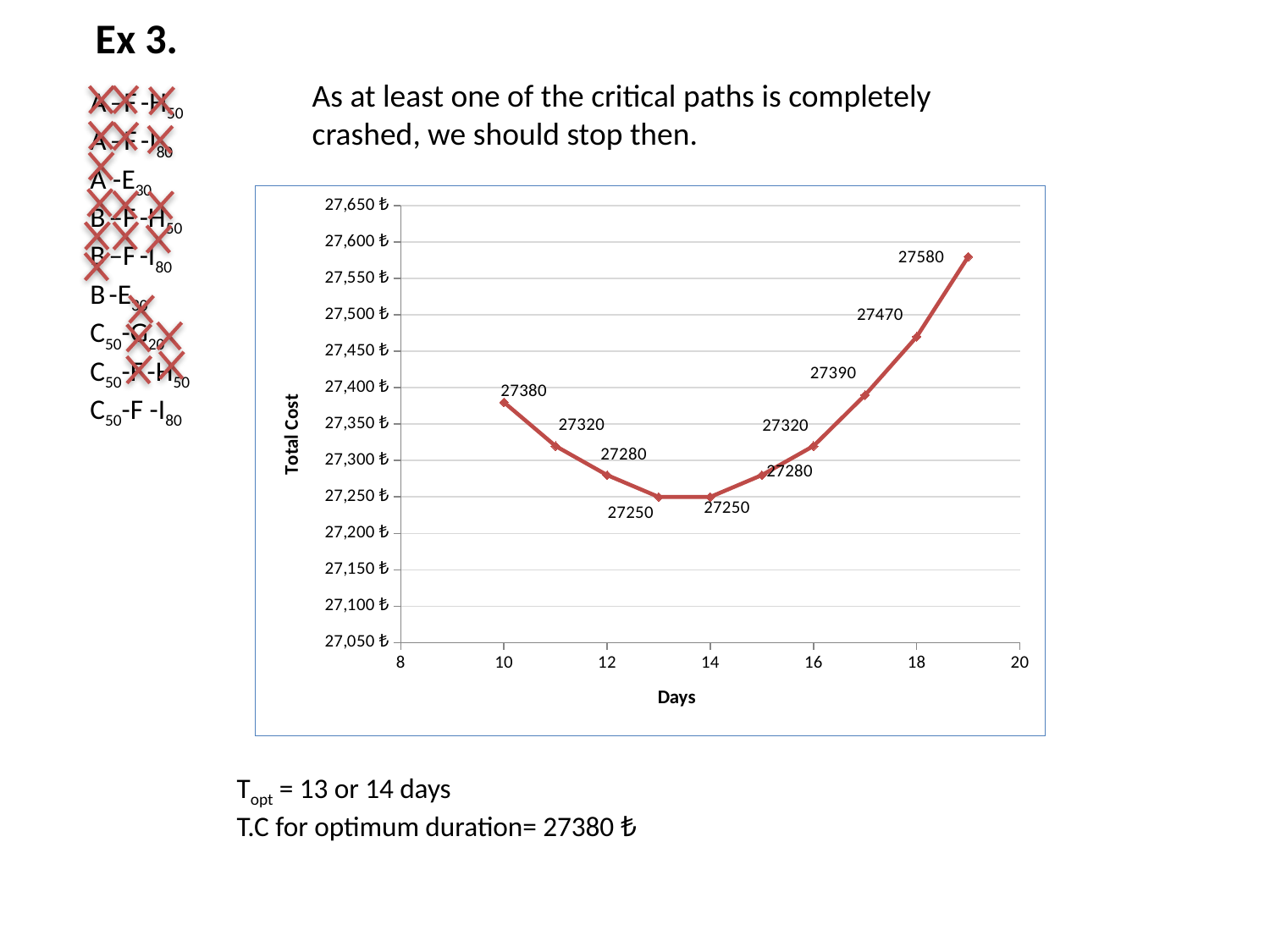
How many data points are plotted on the chart? 10 What is the label of the vertical axis? Total Cost What is the total cost at 10 days? 27380 What is the total cost at 19 days? 27580 What is the total cost at 17 days? 27390 What is the total cost at 13 days? 27250 What is the lowest total cost plotted on the chart? 27250 What is the difference between the total cost at 19 days and the total cost at 10 days? 200 What type of chart is shown on the slide? line chart At how many days is the total cost highest? 19 Which is larger, the total cost at 11 days or the total cost at 16 days? They are equal (27320) Does the total cost rise or fall as days increase from 14 to 19? rise